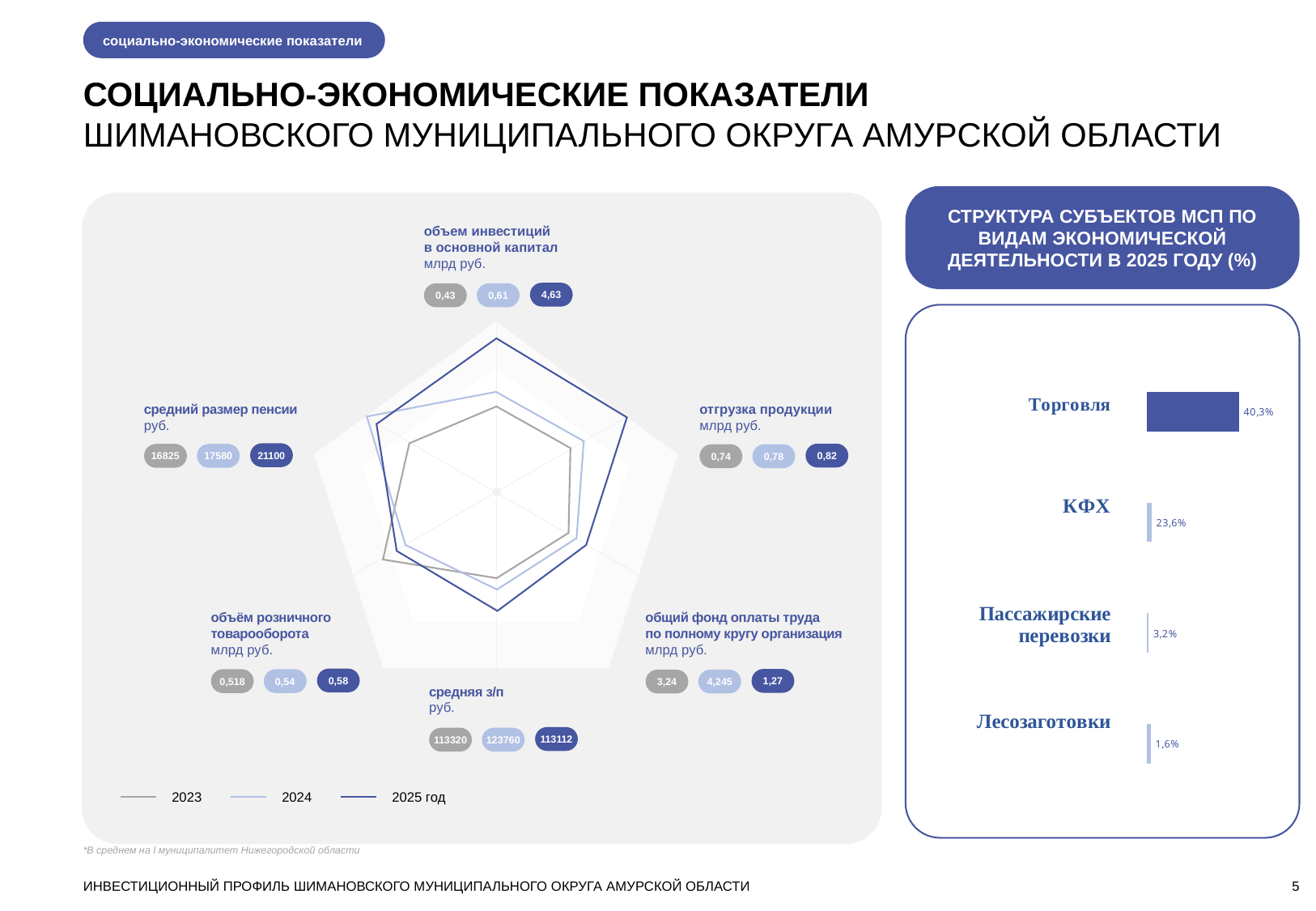
On the bar chart 'Структура субъектов МСП по видам экономической деятельности в 2025 году (%)', how many categories are shown? 4 On the radar chart on the left, how many series does the legend list? 3 On the radar chart on the left, which is larger for 'средняя з/п': the 2024 value or the 2025 value? 2024 (123760) On the bar chart 'Структура субъектов МСП по видам экономической деятельности в 2025 году (%)', which category has the lowest value? Лесозаготовки On the bar chart 'Структура субъектов МСП по видам экономической деятельности в 2025 году (%)', what is the value for Торговля? 40,3% On the radar chart on the left, what is the value of 'средний размер пенсии' for 2023? 16825 On the bar chart 'Структура субъектов МСП по видам экономической деятельности в 2025 году (%)', which category has the highest value? Торговля On the radar chart on the left, which years are listed in the legend? 2023, 2024, 2025 On the radar chart on the left, what is the difference between the 2025 and 2023 values of 'отгрузка продукции'? 0,08 On the radar chart on the left, what is the value of 'объем инвестиций в основной капитал' for 2025? 4,63 What kind of chart is the chart on the right side of the slide? Bar chart On the bar chart 'Структура субъектов МСП по видам экономической деятельности в 2025 году (%)', what is the difference between Торговля and КФХ? 16,7%